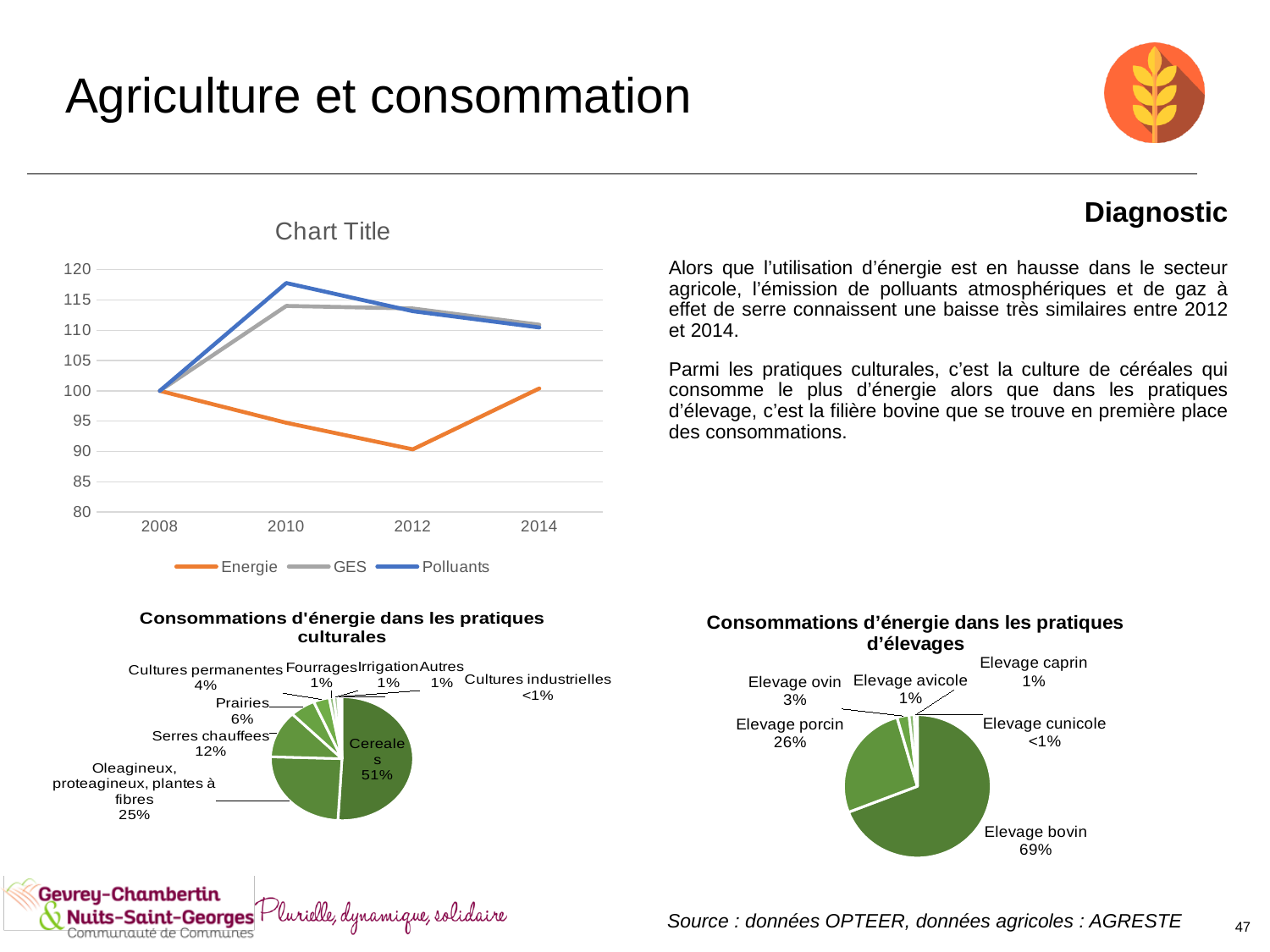
In the pie chart "Consommations d'énergie dans les pratiques culturales", what share is Serres chauffees? 12% In the line chart titled "Chart Title", which series has the higher value in 2010, Energie or Polluants? Polluants In the line chart titled "Chart Title", is the value for Polluants in 2010 greater or less than 115? greater In the line chart titled "Chart Title", does the Energie series rise or fall between 2012 and 2014? rise In the line chart titled "Chart Title", is the value for Energie in 2012 greater or less than 95? less In the pie chart "Consommations d'énergie dans les pratiques culturales", what is the difference between the shares of Cereales and Oleagineux, proteagineux, plantes à fibres? 26% In the line chart titled "Chart Title", how many years are shown on the x axis? 4 In the pie chart "Consommations d'énergie dans les pratiques culturales", what share is Cereales? 51% In the line chart titled "Chart Title", how many series does the legend list? 3 What kind of chart is "Consommations d'énergie dans les pratiques d'élevages"? pie chart In the pie chart "Consommations d'énergie dans les pratiques d'élevages", what share is Elevage porcin? 26% In the pie chart "Consommations d'énergie dans les pratiques d'élevages", which category has the largest share? Elevage bovin